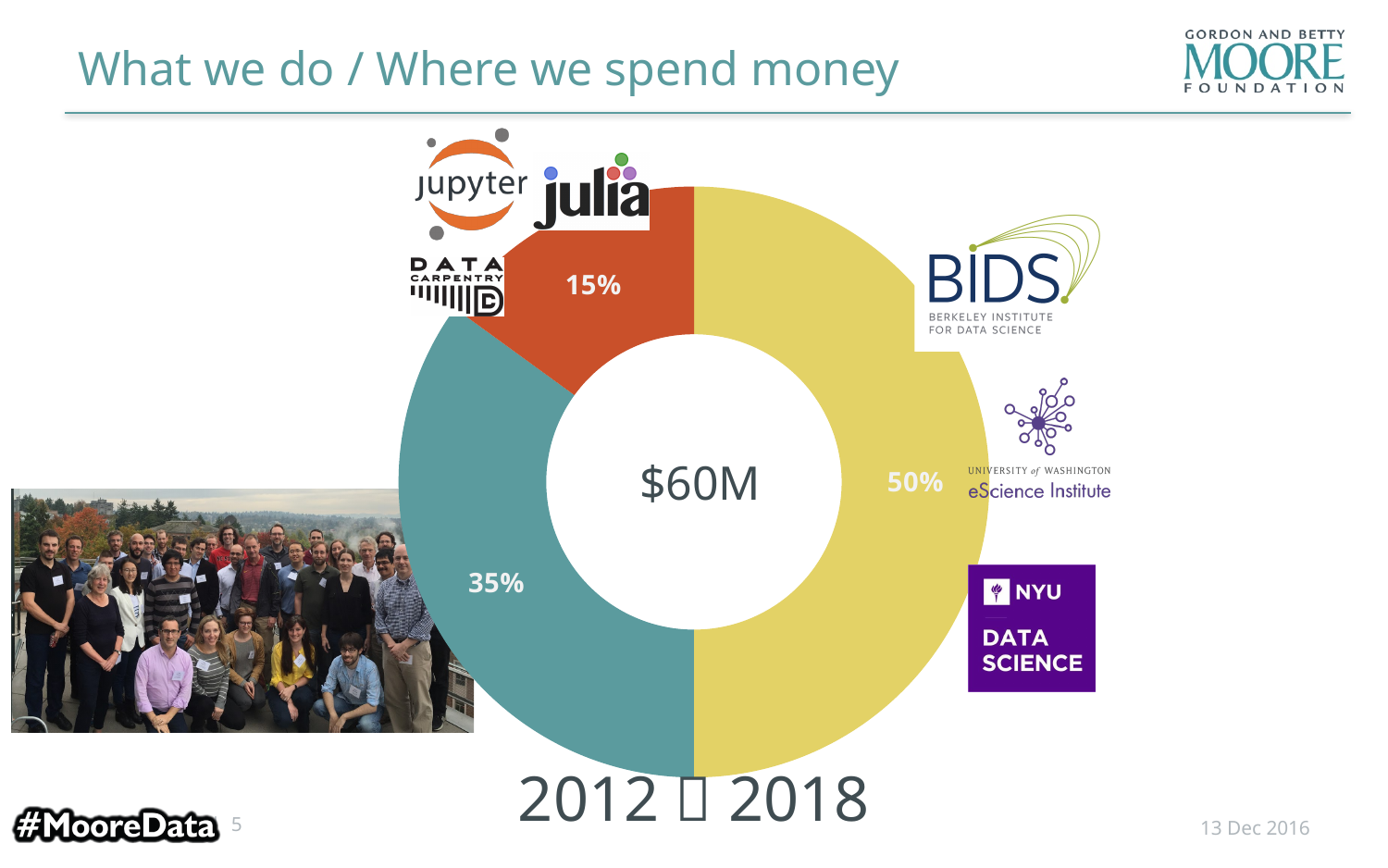
What is the difference in percentage points between the yellow slice and the teal slice? 15 What percentage is shown on the smallest slice of the pie chart? 15% What percentage is shown on the largest slice of the pie chart? 50% What percentage is labelled on the yellow slice of the pie chart? 50% How many slices does the pie chart have? 3 What percentage is labelled on the orange slice next to the Jupyter and Julia logos? 15% What kind of chart is shown on the slide? pie chart (donut) What total amount is printed in the centre of the pie chart? $60M What time period is printed below the pie chart? 2012 – 2018 Which slice is larger, the teal slice or the orange slice? the teal slice What percentage is labelled on the teal slice of the pie chart? 35% What is the difference in percentage points between the teal slice and the orange slice? 20